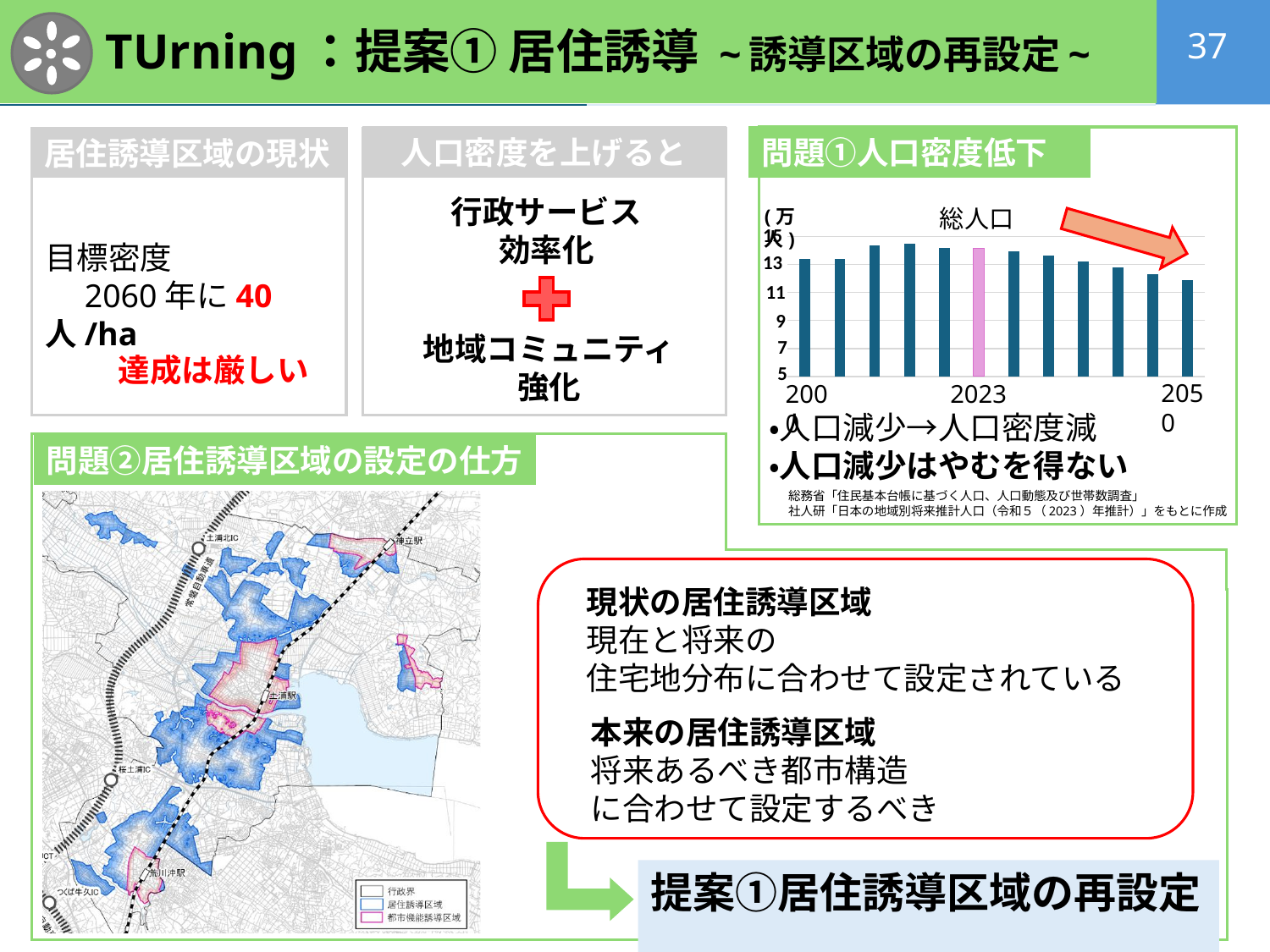
In the 総人口 chart, do the values rise or fall from 2023 to 2050? fall In the 総人口 chart, is the value for 2023 greater or less than 13? greater In the 総人口 chart, is the value for 2050 greater or less than 11? greater In the 総人口 chart, is the value for 2050 greater or less than 13? less In the 総人口 chart, which year's bar is highlighted in pink? 2023 What kind of chart is shown under 問題①人口密度低下? bar chart In the 総人口 chart, which year has the lowest bar? 2050 In the 総人口 chart, which is larger, the value for 2023 or the value for 2050? 2023 What is the title of the chart under 問題①人口密度低下? 総人口 How many bars are plotted in the 総人口 chart? 12